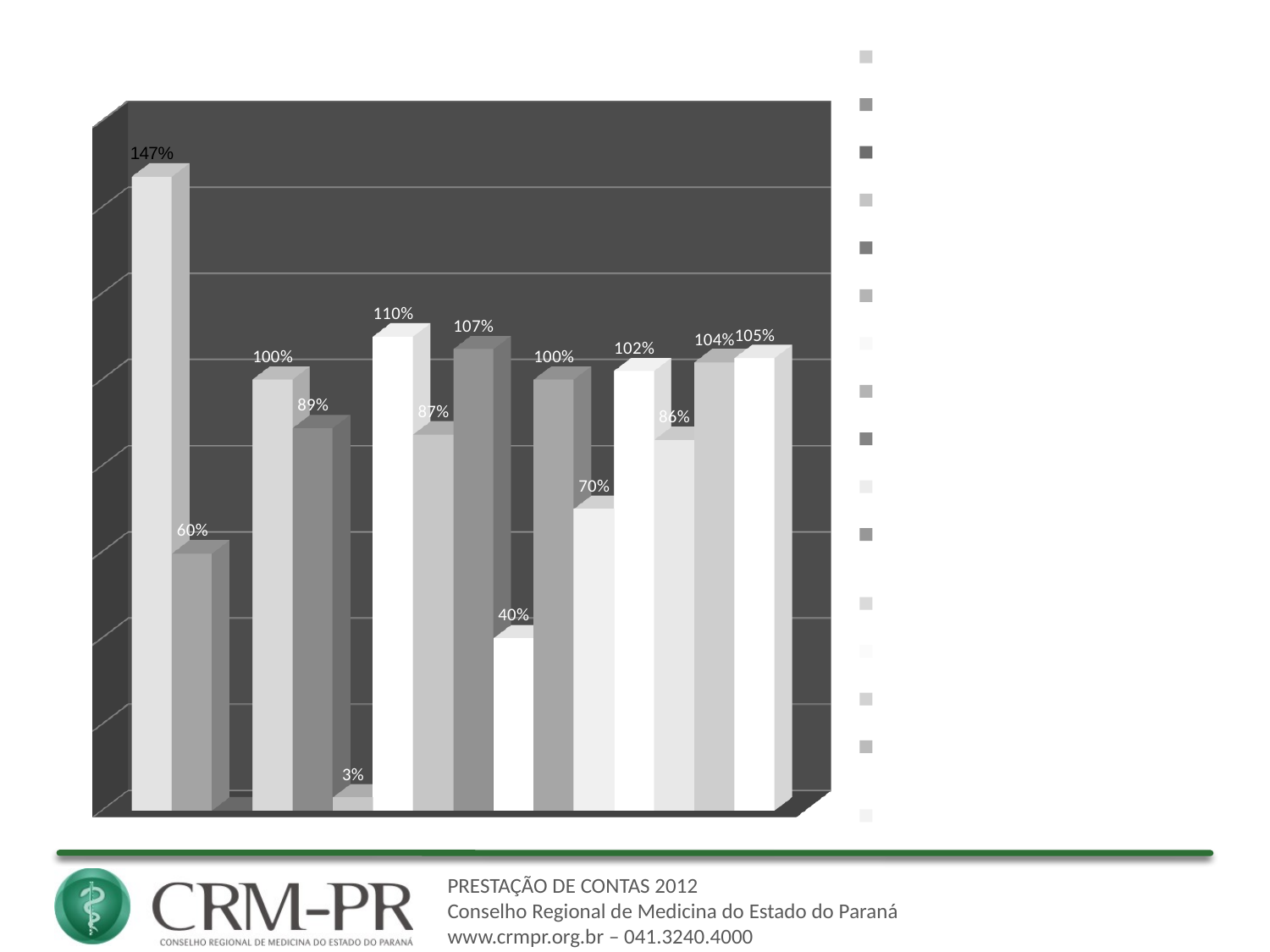
What is the lowest value shown in the chart? 3% What is the value of the rightmost bar in the chart? 105% What is the highest value shown in the chart? 147% What is the value of the leftmost bar in the chart? 147% Does the chart display a title above the plot area? No What is the value of the second bar from the left? 60% Which is larger, the leftmost bar or the rightmost bar? the leftmost bar What kind of chart is shown on the slide? bar chart How many bars have a value above 100%? 6 How many bars are plotted in the chart? 15 What is the difference between the highest and lowest values in the chart? 144% How many bars are labelled exactly 100%? 2